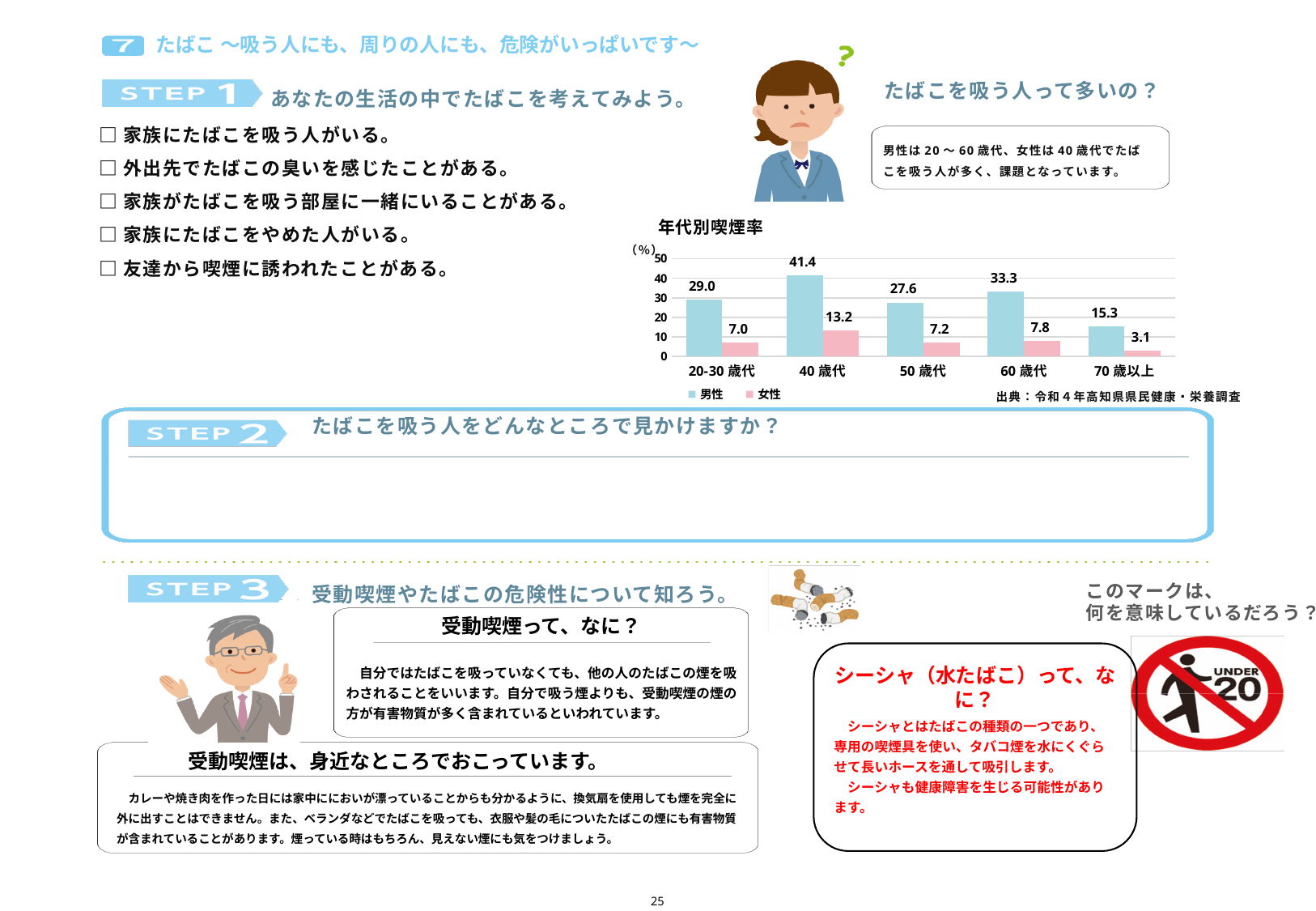
How many age categories are shown on the x axis of the 年代別喫煙率 chart? 5 How many series does the legend of the 年代別喫煙率 chart list? 2 What is the unit shown on the y axis of the 年代別喫煙率 chart? % In the 年代別喫煙率 chart, what is the value for 女性 in the 70 歳以上 category? 3.1 What type of chart is the 年代別喫煙率 chart? bar chart In the 年代別喫煙率 chart, what is the difference between the 男性 and 女性 values in the 40 歳代 category? 28.2 In the 年代別喫煙率 chart, is the 男性 value for 70 歳以上 greater or less than 20? less In the 年代別喫煙率 chart, which is larger: the 男性 value for 20-30 歳代 or the 男性 value for 50 歳代? 20-30 歳代 In the 年代別喫煙率 chart, what is the value for 男性 in the 60 歳代 category? 33.3 In the 年代別喫煙率 chart, what is the value for 男性 in the 40 歳代 category? 41.4 In the 年代別喫煙率 chart, which age category has the highest value for 男性? 40 歳代 In the 年代別喫煙率 chart, which age category has the lowest value for 女性? 70 歳以上